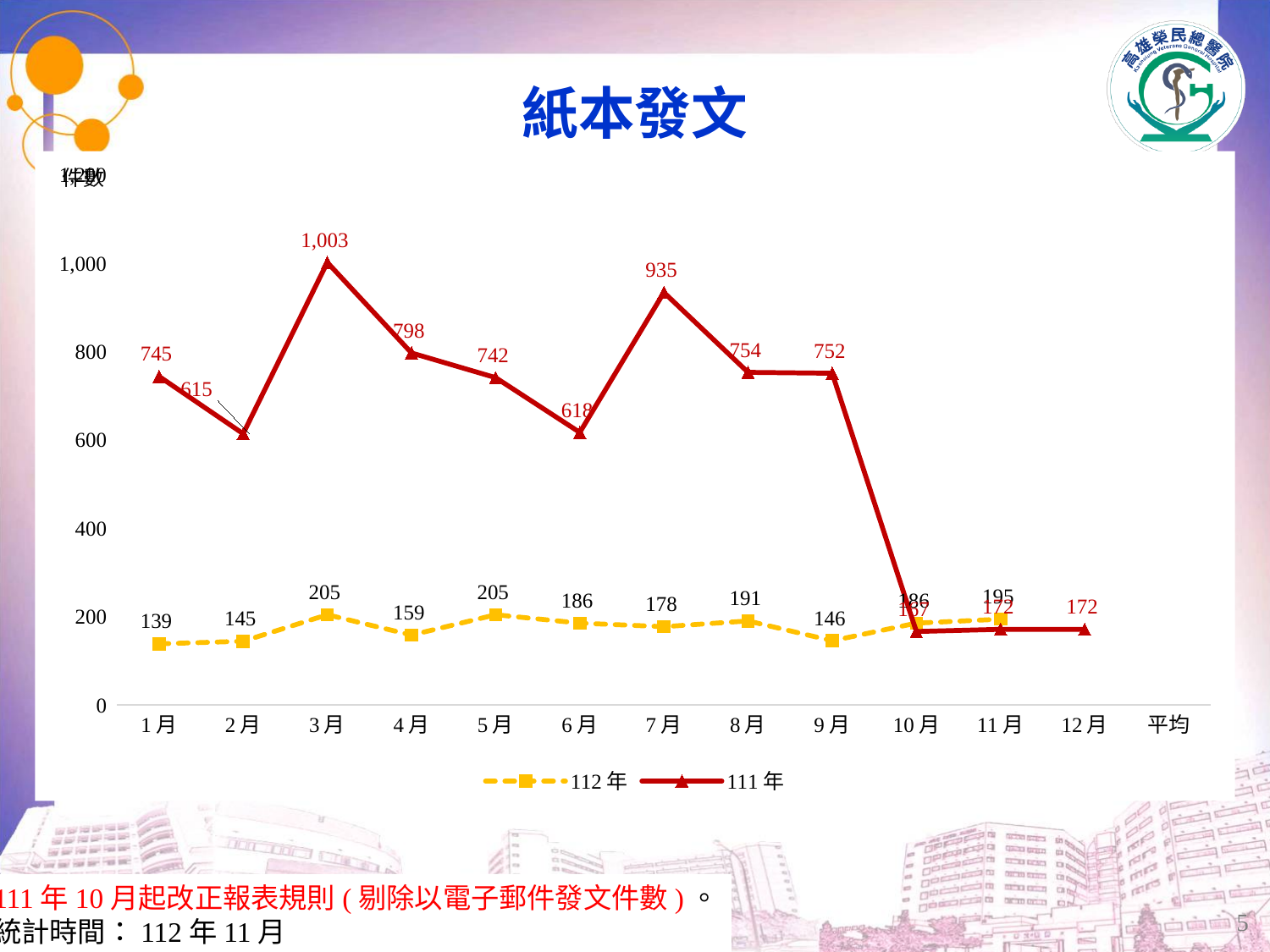
In which month is the 111年 series highest? 3月 What kind of chart is shown on the slide? line chart What is the difference between the 112年 values for 3月 and 1月? 66 What is the value for 111年 in 12月? 172 In which month is the 112年 series lowest? 1月 What is the difference between the 111年 values for 3月 and 7月? 68 Does the 111年 series rise or fall from 8月 to 10月? fall What is the value for 112年 in 8月? 191 Is the value for 111年 in 9月 greater or less than 600? greater What is the value for 111年 in 3月? 1,003 Which is larger for 111年: the value in 4月 or the value in 5月? 4月 How many series does the legend list? 2